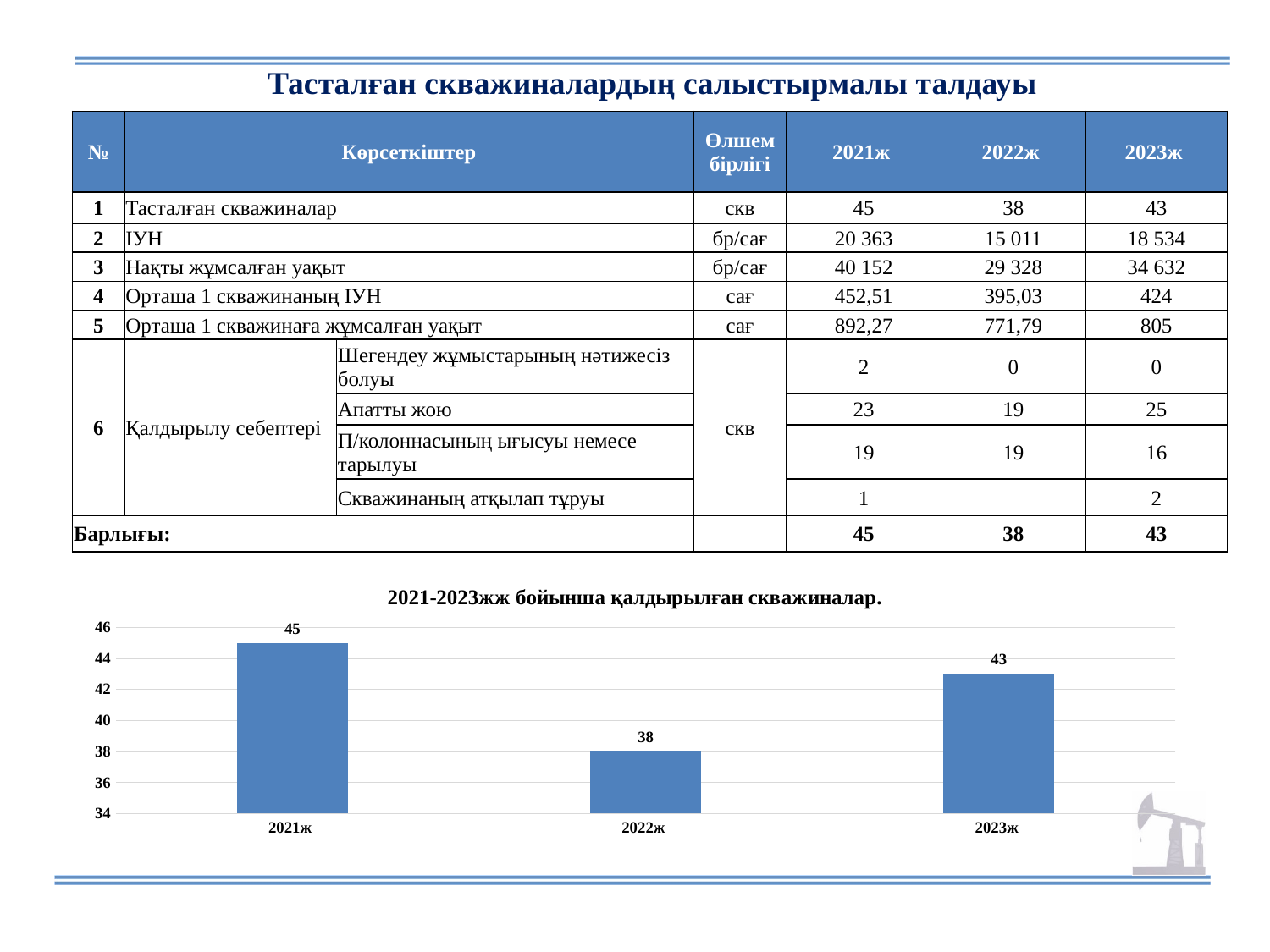
What is the difference between the values for 2023ж and 2022ж? 5 Which year has the highest value in the chart? 2021ж What is the title of the chart? 2021-2023жж бойынша қалдырылған скважиналар. What is the difference between the values for 2021ж and 2022ж? 7 Which is larger, the value for 2021ж or the value for 2023ж? 2021ж How many categories are shown on the x axis of the chart? 3 What is the value for 2022ж in the chart? 38 What kind of chart is shown on the slide? bar chart What is the value for 2021ж in the chart? 45 What is the value for 2023ж in the chart? 43 Is the value for 2022ж greater or less than 40? less Which year has the lowest value in the chart? 2022ж